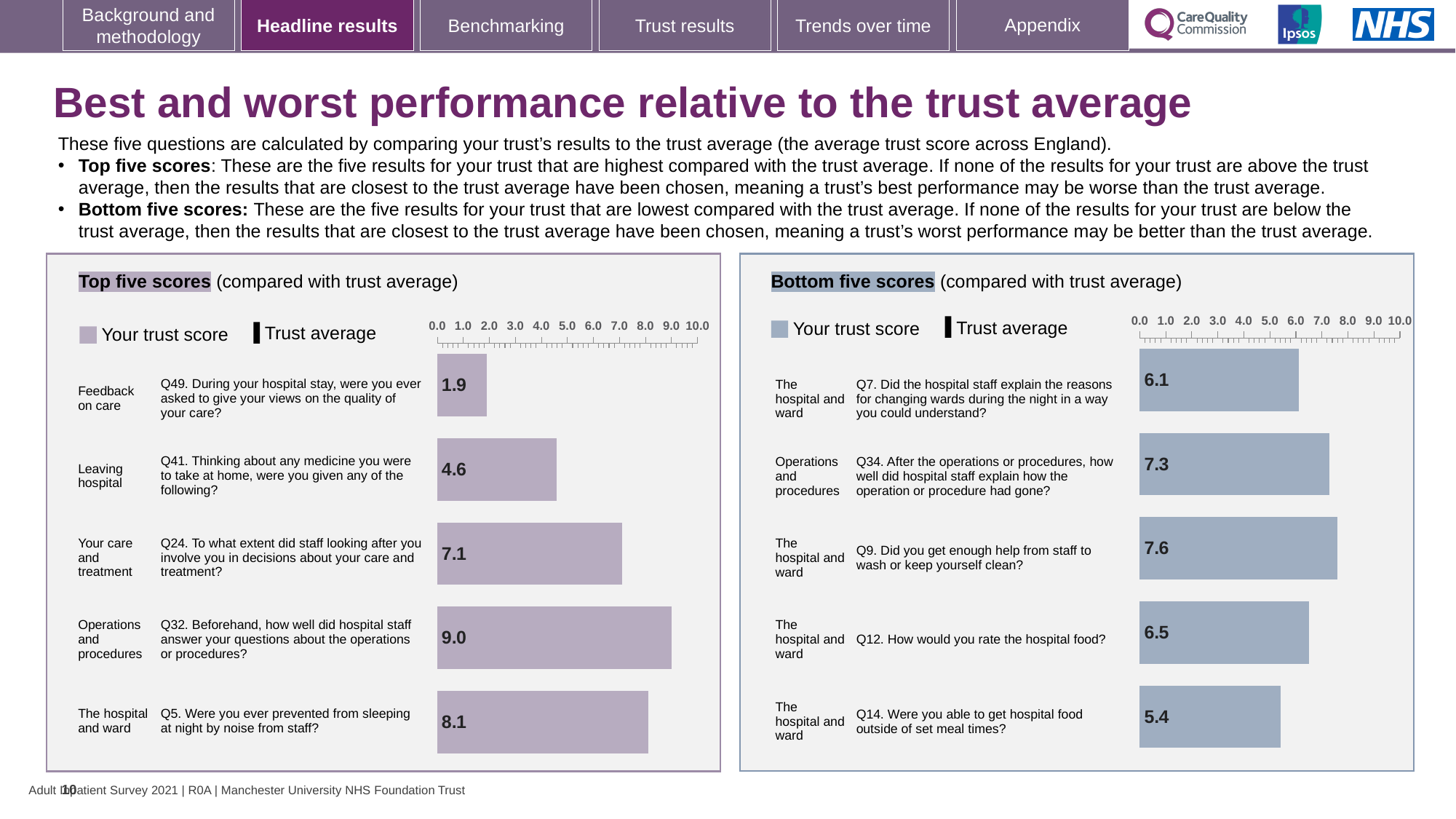
In the Top five scores chart, which question has the highest trust score? Q32 In the Bottom five scores chart, which has the larger trust score, Q34 or Q12? Q34 In the Bottom five scores chart, which question has the lowest trust score? Q14 In the Top five scores chart, what is the trust score for Q32 about how well hospital staff answered questions about operations or procedures? 9.0 In the Bottom five scores chart, which question has the highest trust score? Q9 In the Bottom five scores chart, what is the trust score for Q14 about getting hospital food outside of set meal times? 5.4 In the Top five scores chart, which question has the lowest trust score? Q49 How many questions are shown in the Bottom five scores chart? 5 In the Top five scores chart, what is the difference between the trust scores for Q32 and Q49? 7.1 In the Bottom five scores chart, what is the trust score for Q9 about getting enough help from staff to wash or keep yourself clean? 7.6 In the Top five scores chart, is the trust score for Q5 greater or less than 7.0? greater What type of chart is used for the Top five scores? Bar chart